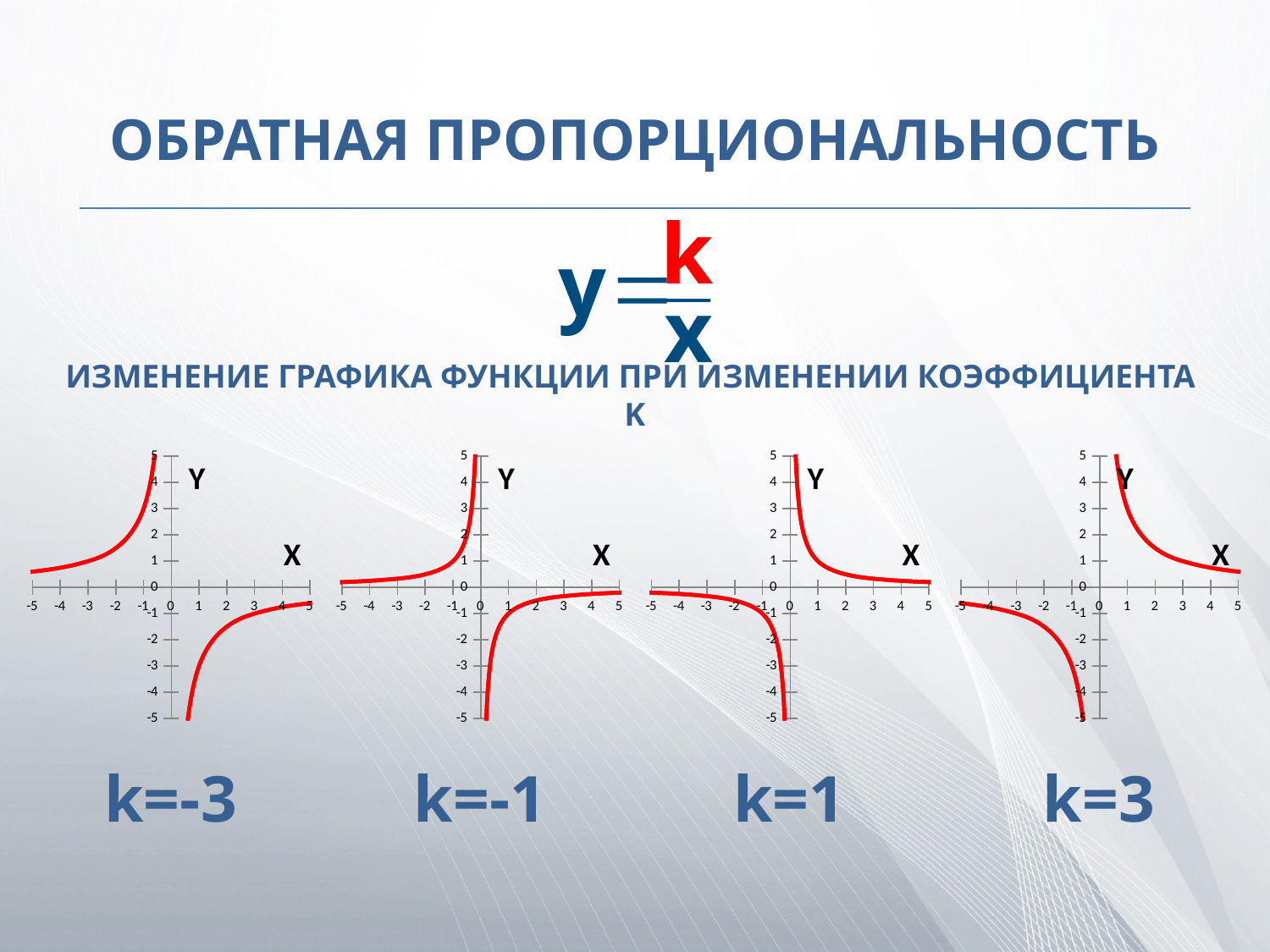
How many charts are shown on the slide? 4 In the k=1 chart, for positive x, does the curve rise or fall as x increases? fall What kind of chart is used for each of the four graphs on the slide? line chart What is the highest value shown on the y axis of the k=1 chart? 5 In the k=1 chart, is the value of the curve at x=5 greater or less than 1? less What is the lowest value shown on the x axis of the k=3 chart? -5 In the k=3 chart, is the value of the curve at x=1 greater or less than 2? greater In the k=-1 chart, is the value of the curve at x=-1 greater or less than 0? greater In the k=-1 chart, for positive x, does the curve rise or fall as x increases? rise In the k=3 chart, for negative x, does the curve rise or fall as x increases toward 0? fall In the k=3 chart, which is larger: the value of the curve at x=1 or at x=3? x=1